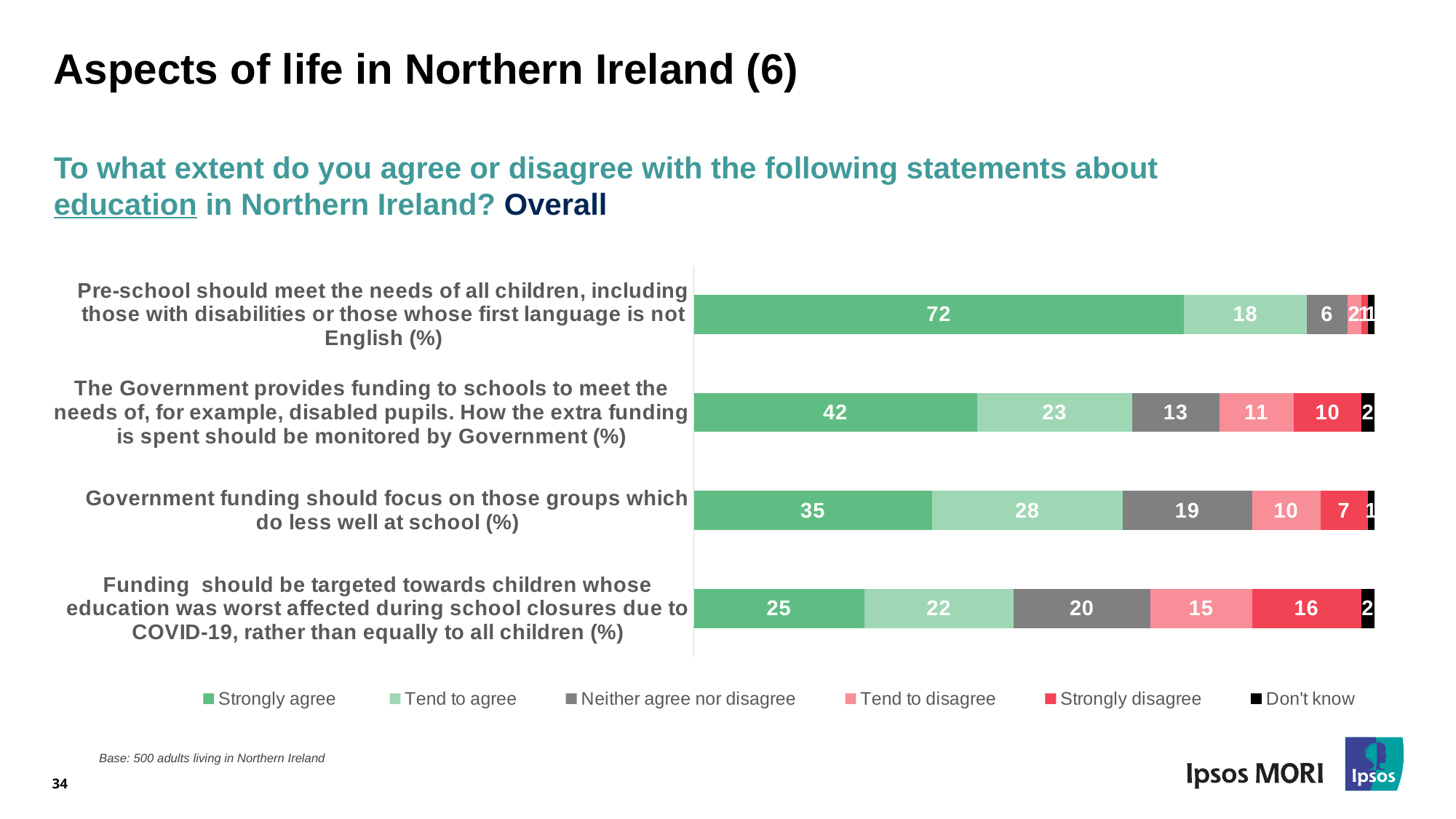
What kind of chart is shown on the slide? Stacked bar chart Which statement has the highest 'Strongly agree' percentage? Pre-school should meet the needs of all children, including those with disabilities or those whose first language is not English What percentage neither agree nor disagree that Government funding should focus on those groups which do less well at school? 19 What is the difference between the 'Strongly agree' percentage for the pre-school statement and the 'Strongly agree' percentage for the statement that Government funding should focus on those groups which do less well at school? 37 Which is larger: the 'Tend to disagree' percentage for the statement about funding being targeted towards children worst affected by COVID-19 school closures, or the 'Tend to disagree' percentage for the statement about Government funding focusing on groups which do less well at school? Funding should be targeted towards children whose education was worst affected during school closures due to COVID-19 What is the base stated for the chart? 500 adults living in Northern Ireland Which statement has the lowest 'Strongly agree' percentage? Funding should be targeted towards children whose education was worst affected during school closures due to COVID-19, rather than equally to all children How many statements (categories) are plotted in the chart? 4 What percentage strongly disagree that funding should be targeted towards children whose education was worst affected during school closures due to COVID-19, rather than equally to all children? 16 How many series does the legend list? 6 What percentage tend to agree that the Government provides funding to schools to meet the needs of, for example, disabled pupils, and how the extra funding is spent should be monitored by Government? 23 What percentage strongly agree that pre-school should meet the needs of all children, including those with disabilities or those whose first language is not English? 72